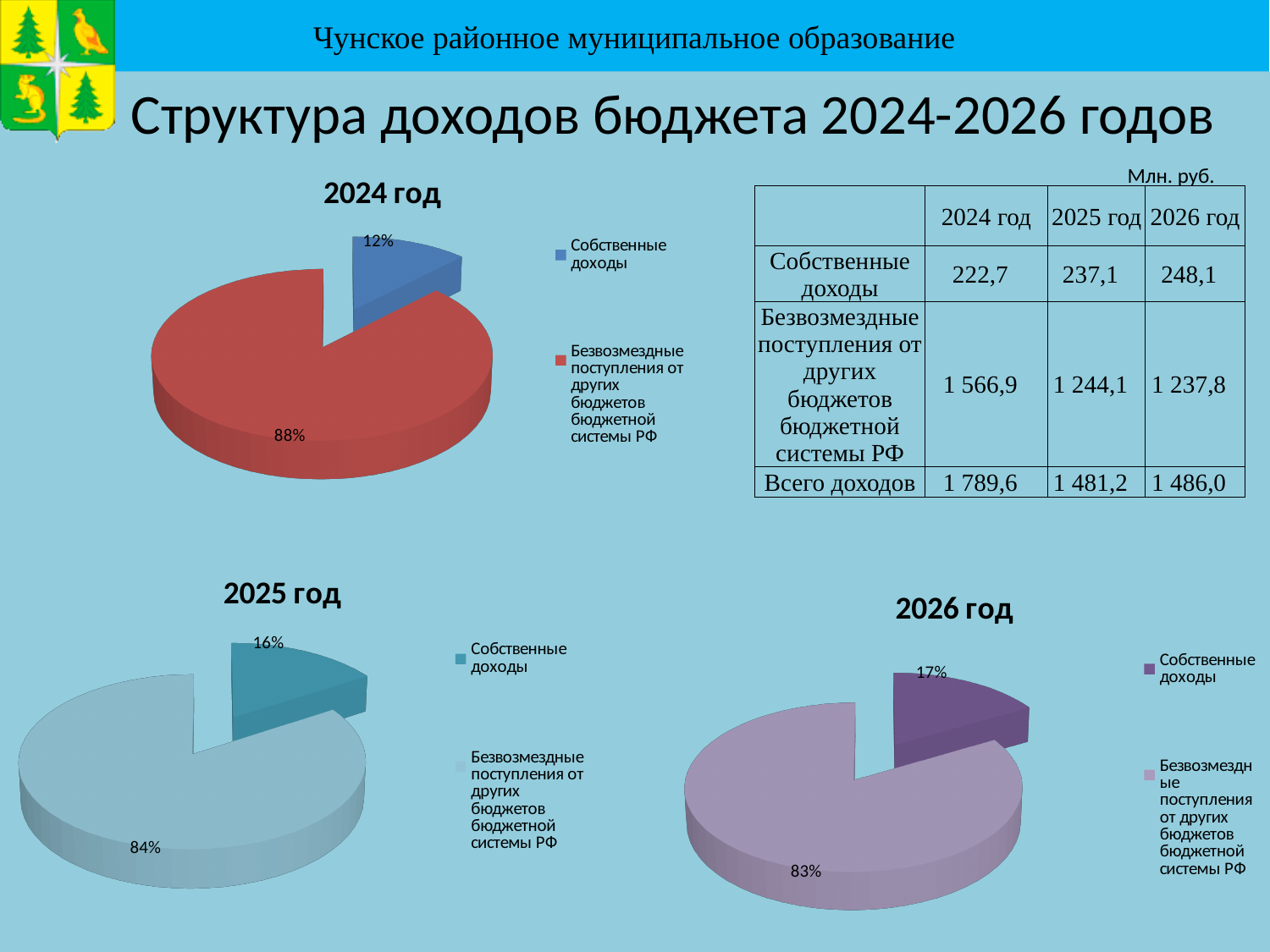
What kind of chart is the "2024 год" chart? Pie chart In the "2024 год" chart, what share is labelled for Безвозмездные поступления от других бюджетов бюджетной системы РФ? 88% In the "2024 год" chart, what is the difference in percentage points between the two slices? 76 In the "2026 год" chart, which category has the smallest slice? Собственные доходы In the "2026 год" chart, what share is labelled for Безвозмездные поступления от других бюджетов бюджетной системы РФ? 83% How many slices does the "2026 год" chart have? 2 In the "2024 год" chart, what share is labelled for Собственные доходы? 12% In the "2025 год" chart, which category has the largest slice? Безвозмездные поступления от других бюджетов бюджетной системы РФ How many entries does the legend of the "2025 год" chart list? 2